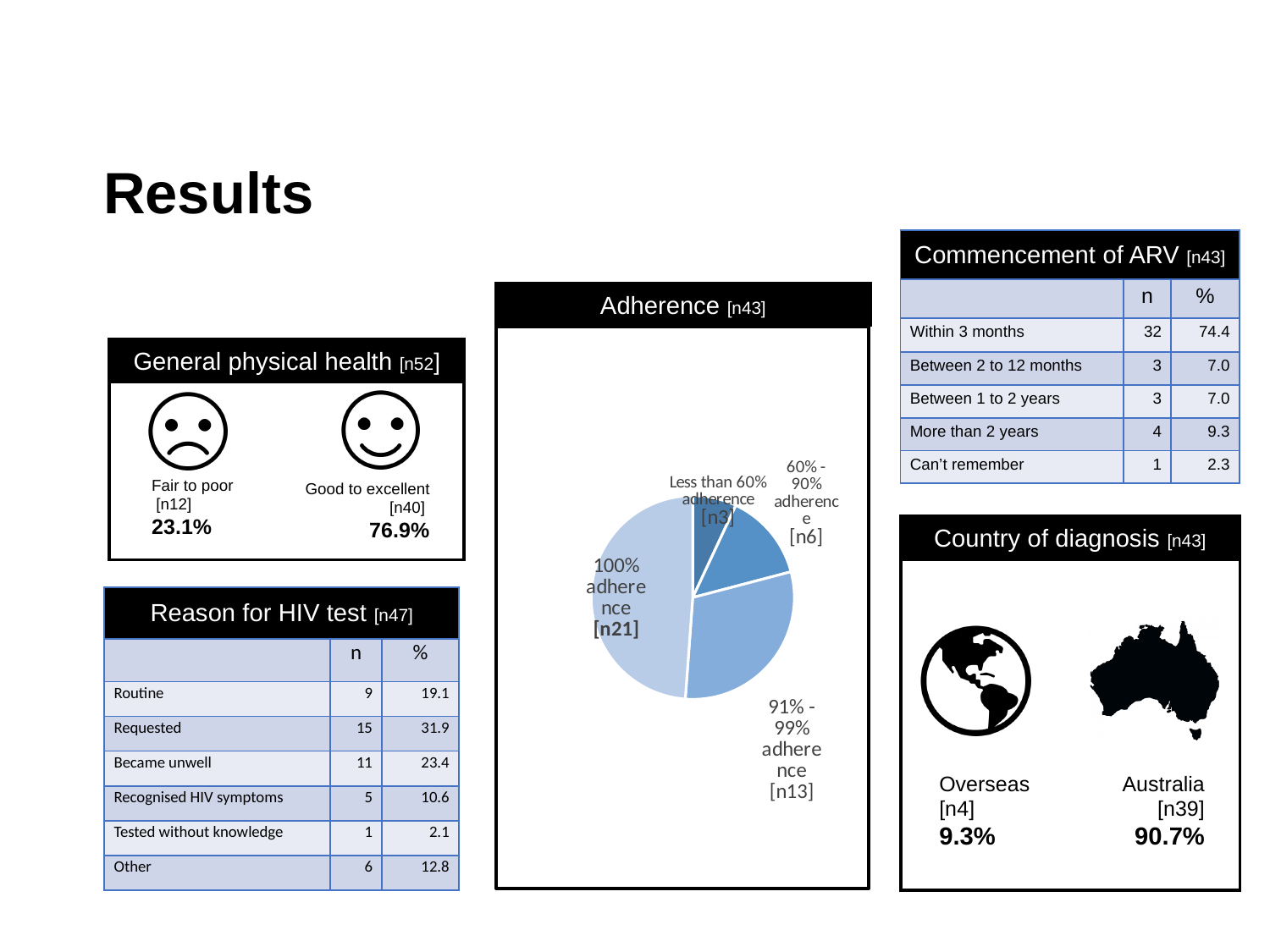
What type of chart is the Adherence chart? pie chart In the Adherence pie chart, which is larger: the 60% - 90% adherence slice or the less than 60% adherence slice? 60% - 90% adherence In the Adherence pie chart, how many participants reported less than 60% adherence? n3 In the Adherence pie chart, how many participants reported 100% adherence? n21 Which category in the Adherence pie chart has the smallest slice? Less than 60% adherence In the Adherence pie chart, how many more participants reported 100% adherence than 91% - 99% adherence? 8 Which category in the Adherence pie chart has the largest slice? 100% adherence How many slices does the Adherence pie chart have? 4 In the Adherence pie chart, how many participants reported 60% - 90% adherence? n6 What is the sample size shown in the title of the Adherence pie chart? n43 In the Adherence pie chart, how many participants reported 91% - 99% adherence? n13 What is the total number of participants across all slices of the Adherence pie chart? 43